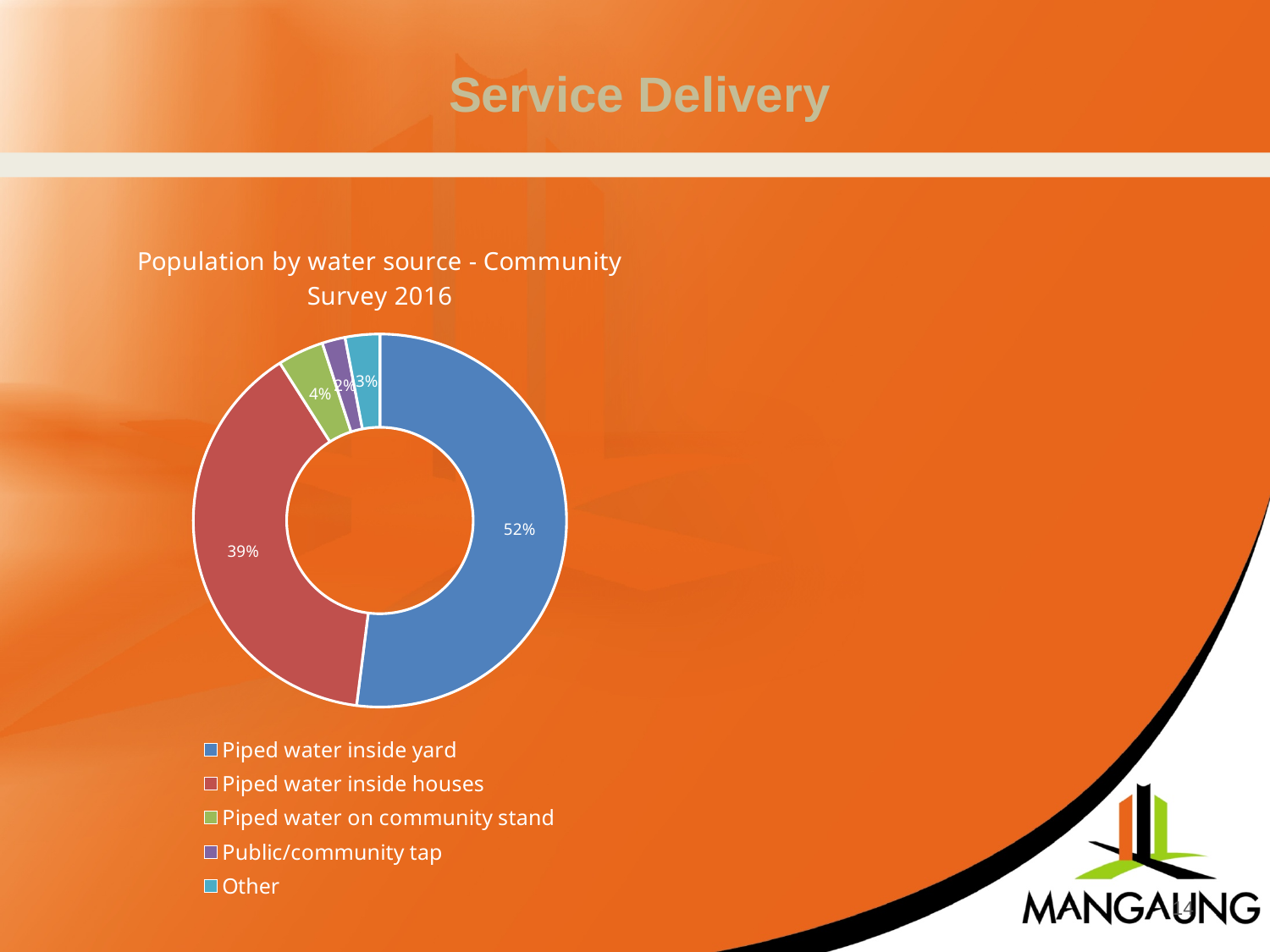
How many categories does the legend list? 5 What share of the population uses piped water on community stand? 4% What share of the population uses piped water inside houses? 39% Which water source has the smallest share? Public/community tap What share of the population uses piped water inside yard? 52% What is the difference between the shares for piped water inside yard and piped water inside houses? 13% What is the title of the chart? Population by water source - Community Survey 2016 What kind of chart is shown on the slide? Doughnut chart What share of the population uses a public/community tap? 2% What share of the population falls under Other? 3% Which is larger, the share for piped water on community stand or the share for Other? Piped water on community stand Which water source has the largest share? Piped water inside yard